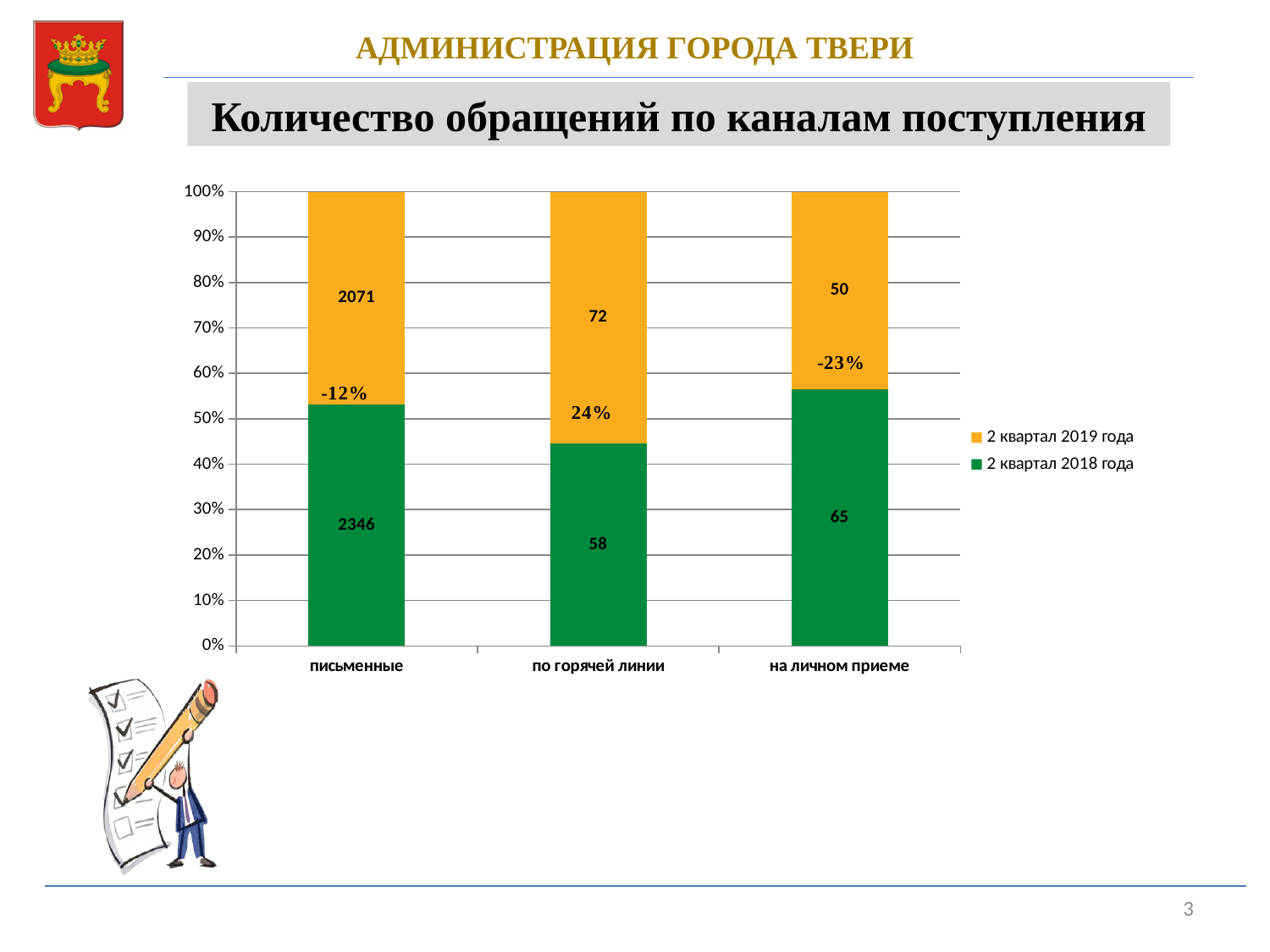
What type of chart is shown on the slide? stacked bar chart What percentage change is labelled on the bar for на личном приеме? -23% How many series does the legend list? 2 What is the difference between the 2 квартал 2018 года and 2 квартал 2019 года values for письменные? 275 What is the value for письменные in the 2 квартал 2018 года series? 2346 For по горячей линии, which series has the larger value: 2 квартал 2019 года or 2 квартал 2018 года? 2 квартал 2019 года What is the value for на личном приеме in the 2 квартал 2018 года series? 65 How many categories are shown on the x axis? 3 What is the value for по горячей линии in the 2 квартал 2019 года series? 72 Which category has the highest value in the 2 квартал 2018 года series? письменные Which category has the lowest value in the 2 квартал 2019 года series? на личном приеме What is the value for письменные in the 2 квартал 2019 года series? 2071